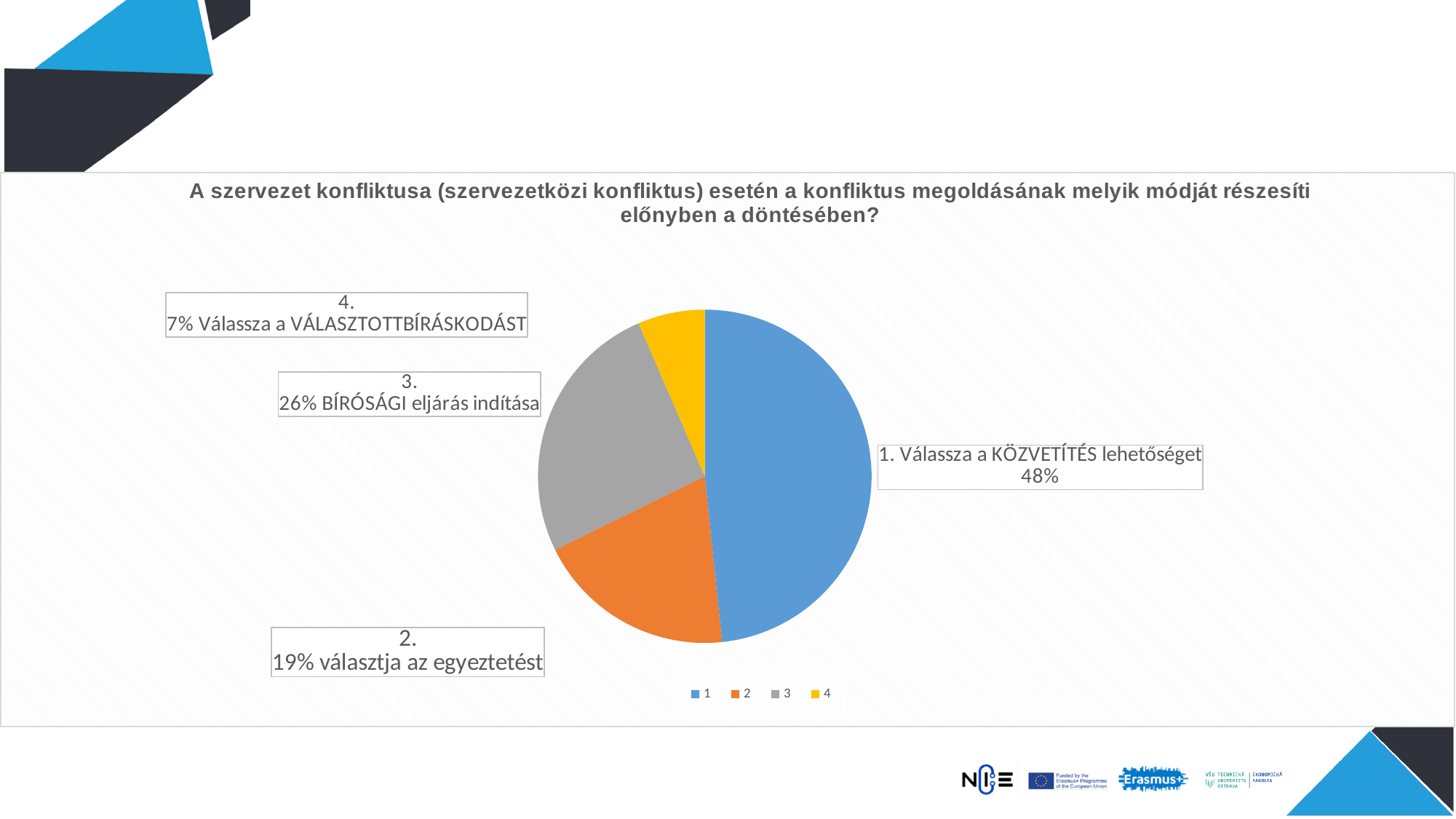
What kind of chart is shown on the slide? pie chart What percentage is shown for slice 3 (BÍRÓSÁGI eljárás indítása)? 26% What colour is the slice for category 4 in the legend? yellow What percentage is shown for slice 2 (választja az egyeztetést)? 19% Which is larger: the share for slice 2 (egyeztetés) or slice 3 (BÍRÓSÁGI eljárás)? slice 3 (BÍRÓSÁGI eljárás indítása) What share of the pie does slice 1 (Válassza a KÖZVETÍTÉS lehetőséget) have? 48% What percentage is shown for slice 4 (Válassza a VÁLASZTOTTBÍRÁSKODÁST)? 7% How many slices does the pie chart have? 4 Which slice has the largest share of the pie? 1. Válassza a KÖZVETÍTÉS lehetőséget Which slice has the smallest share of the pie? 4. Válassza a VÁLASZTOTTBÍRÁSKODÁST How many entries does the legend list? 4 What is the difference in percentage points between slice 1 (48%) and slice 3 (26%)? 22